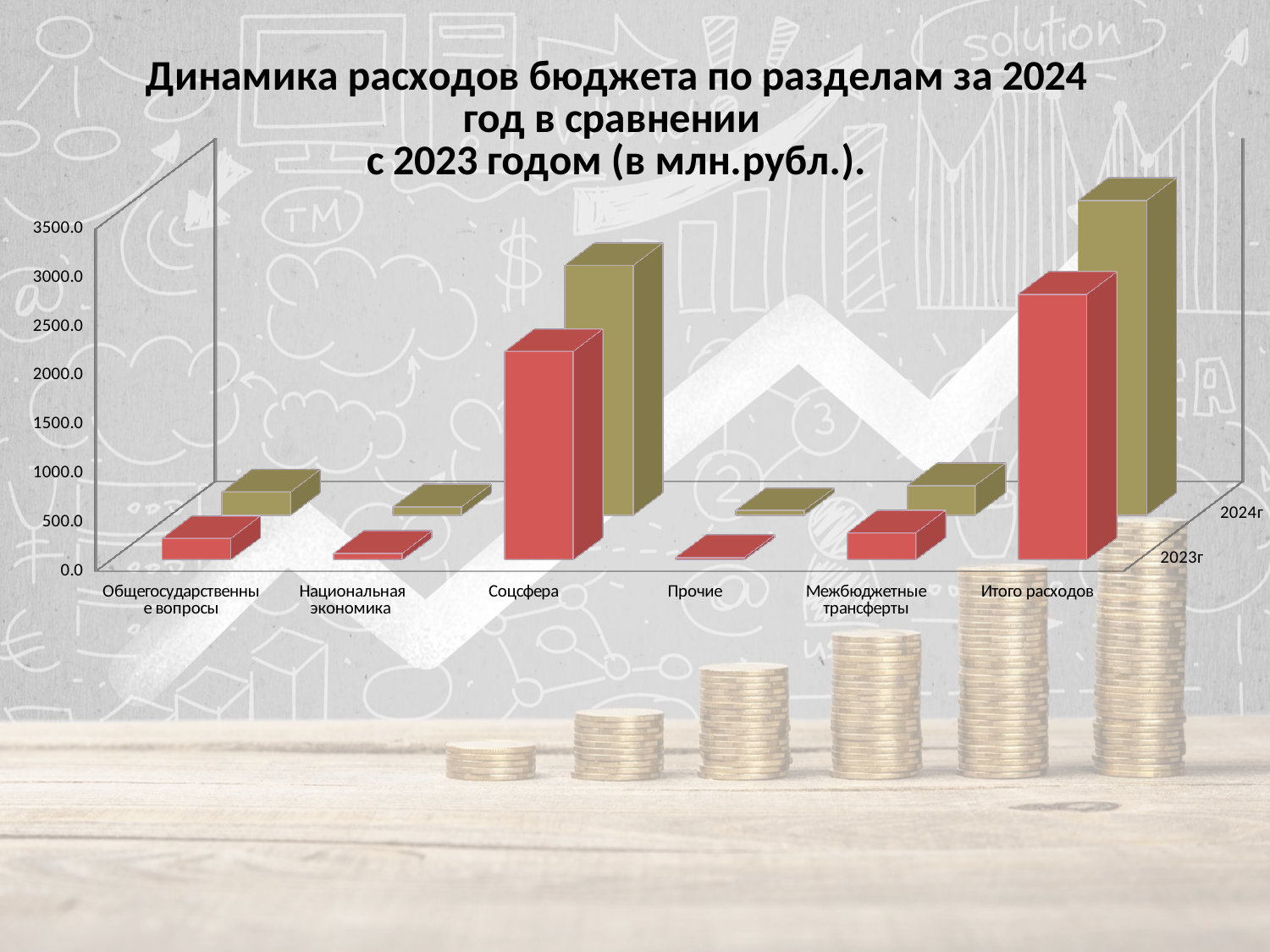
Which series is shown in red on the chart? 2023г Is the 2023г value for Соцсфера greater or less than 1500.0? greater Is the 2023г value for Национальная экономика greater or less than 500.0? less Which category has the lowest value for the 2024г series? Прочие Which category has the lowest value for the 2023г series? Прочие For the 2024г series, which is larger: Соцсфера or Общегосударственные вопросы? Соцсфера What kind of chart is shown on the slide? bar chart Which category has the highest value for the 2023г series? Итого расходов Is the 2024г value for Итого расходов greater or less than 2500.0? greater How many categories are shown along the x axis of the chart? 6 Which category has the highest value for the 2024г series? Итого расходов